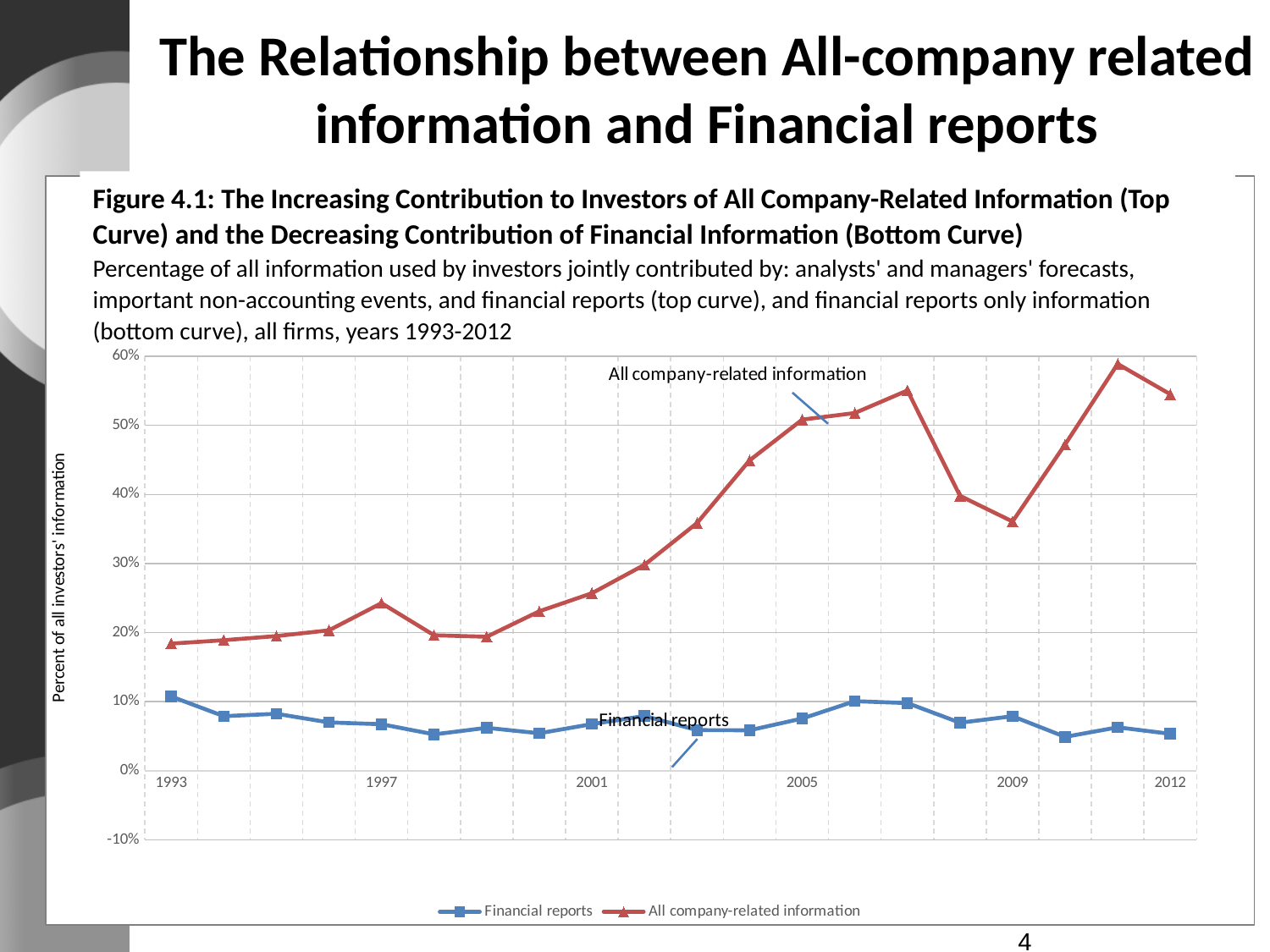
In which year does the All company-related information series reach its highest value? 2011 What kind of chart is shown on the slide? line chart How many series does the legend list? 2 In 2005, which series has the higher value: Financial reports or All company-related information? All company-related information Does the All company-related information series rise or fall from 2007 to 2009? fall Is the value for All company-related information in 1993 greater or less than 20%? less Does the All company-related information series rise or fall from 1993 to 2005? rise What is the label on the vertical axis? Percent of all investors' information How many data points does each series have (years 1993 to 2012)? 20 Is the value for All company-related information in 2011 greater or less than 50%? greater Is the value for All company-related information in 2009 greater or less than 30%? greater